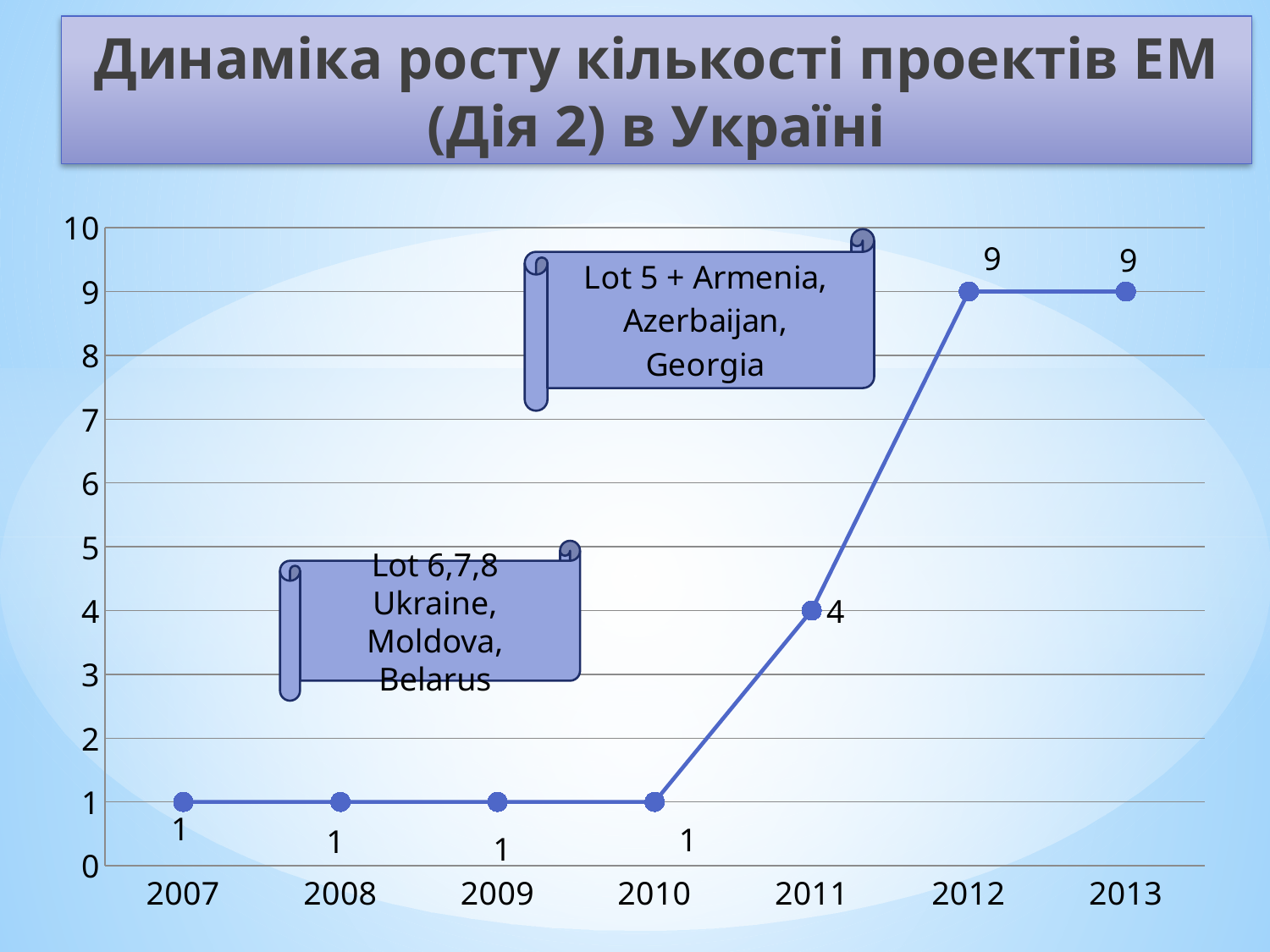
What is the difference between the values for 2012 and 2011? 5 What is the value for 2007? 1 Which is larger, the value for 2011 or the value for 2009? 2011 Is the value for 2012 greater or less than 5? greater What is the value for 2012? 9 What is the value for 2011? 4 Do the values rise or fall from 2010 to 2012? rise What is the value for 2013? 9 Which year has the lowest value, 2010 or 2011? 2010 What is the difference between the values for 2011 and 2010? 3 What kind of chart is shown on the slide? line chart How many years are plotted on the x axis? 7